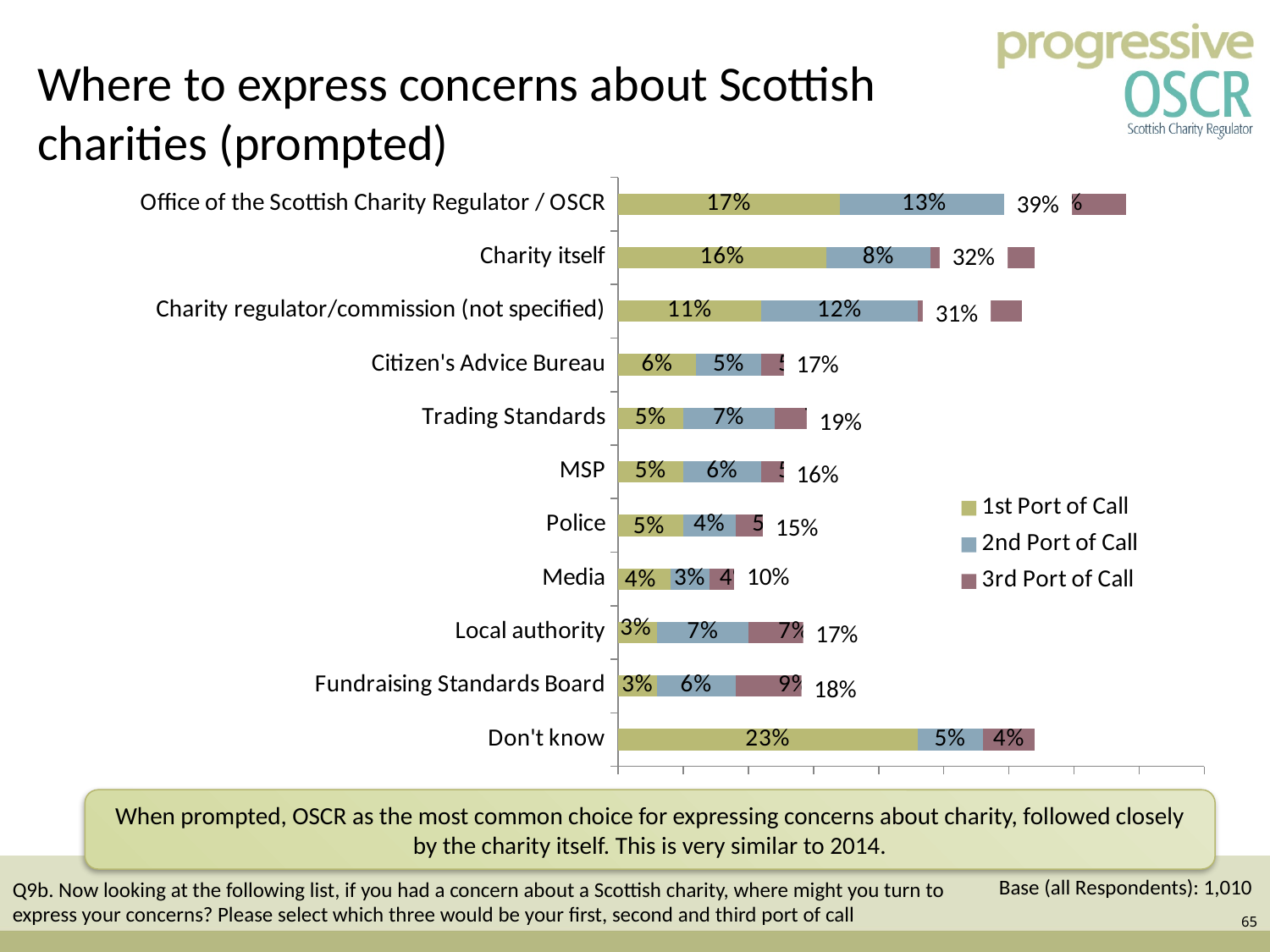
What is the 3rd Port of Call value for Don't know? 4% What is the 1st Port of Call value for Office of the Scottish Charity Regulator / OSCR? 17% What is the 2nd Port of Call value for Charity regulator/commission (not specified)? 12% How many categories are plotted on the chart? 11 What is the 1st Port of Call value for Don't know? 23% What kind of chart is shown on the slide? bar chart What is the 2nd Port of Call value for Trading Standards? 7% What is the difference between the 2nd Port of Call values for Office of the Scottish Charity Regulator / OSCR and Charity itself? 5 percentage points Which has the larger 1st Port of Call value, Charity itself or Charity regulator/commission (not specified)? Charity itself Which category has the highest 1st Port of Call value? Don't know How many series does the legend list? 3 What are the three series named in the legend? 1st Port of Call, 2nd Port of Call, 3rd Port of Call